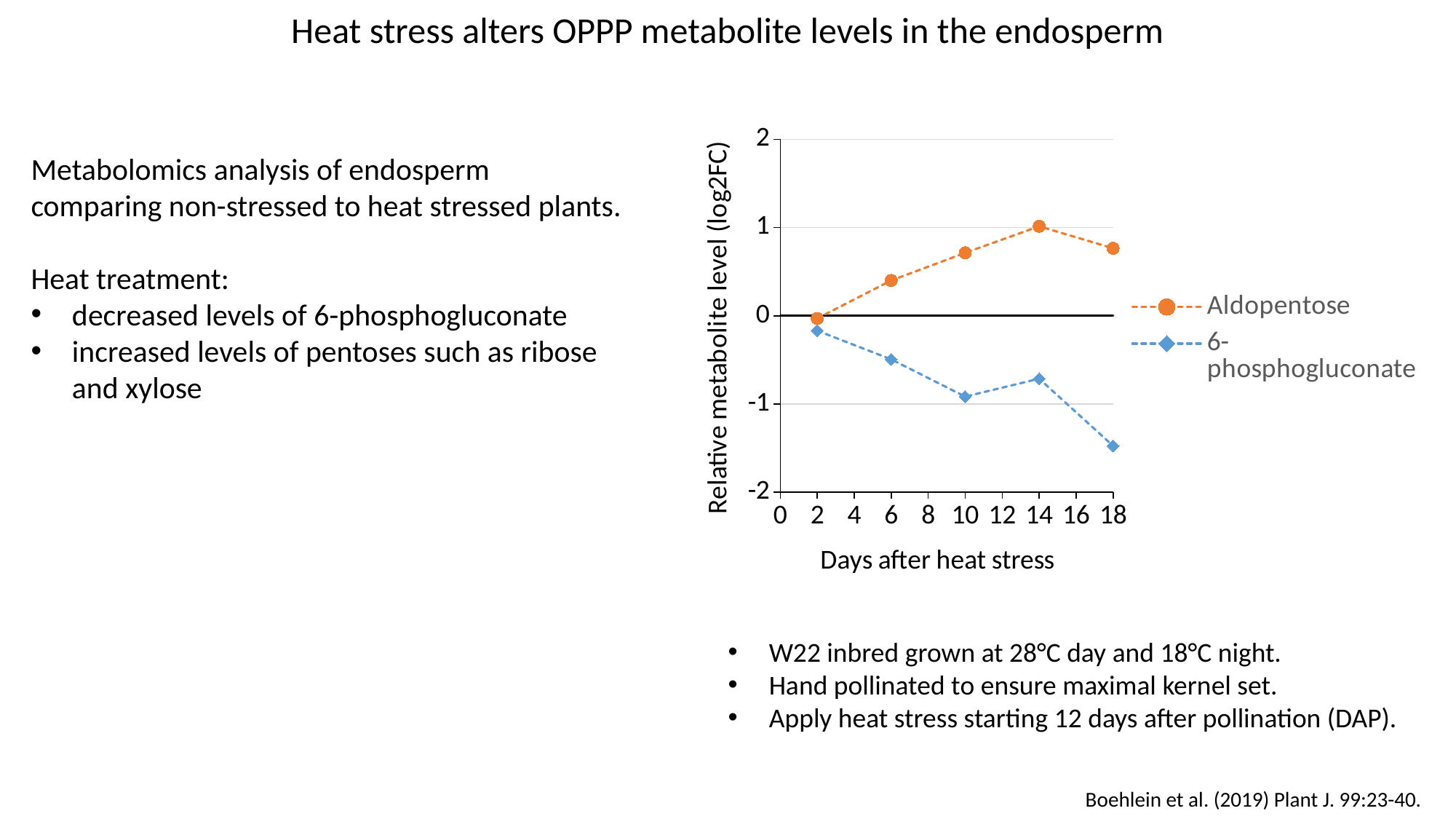
Does the 6-phosphogluconate series generally rise or fall from day 2 to day 18? fall How many data points are plotted for the Aldopentose series? 5 What is the label of the x axis? Days after heat stress Which colour is used for the 6-phosphogluconate series? blue Is the 6-phosphogluconate value at day 18 greater or less than -1? less At which day after heat stress does the Aldopentose series reach its highest value? 14 How many series does the legend list? 2 Is the Aldopentose value at day 14 greater or less than 0? greater Is the Aldopentose value at day 6 greater or less than 1? less At day 10, which series has the higher value, Aldopentose or 6-phosphogluconate? Aldopentose What kind of chart is shown on the slide? line chart At which day after heat stress does the 6-phosphogluconate series reach its lowest value? 18